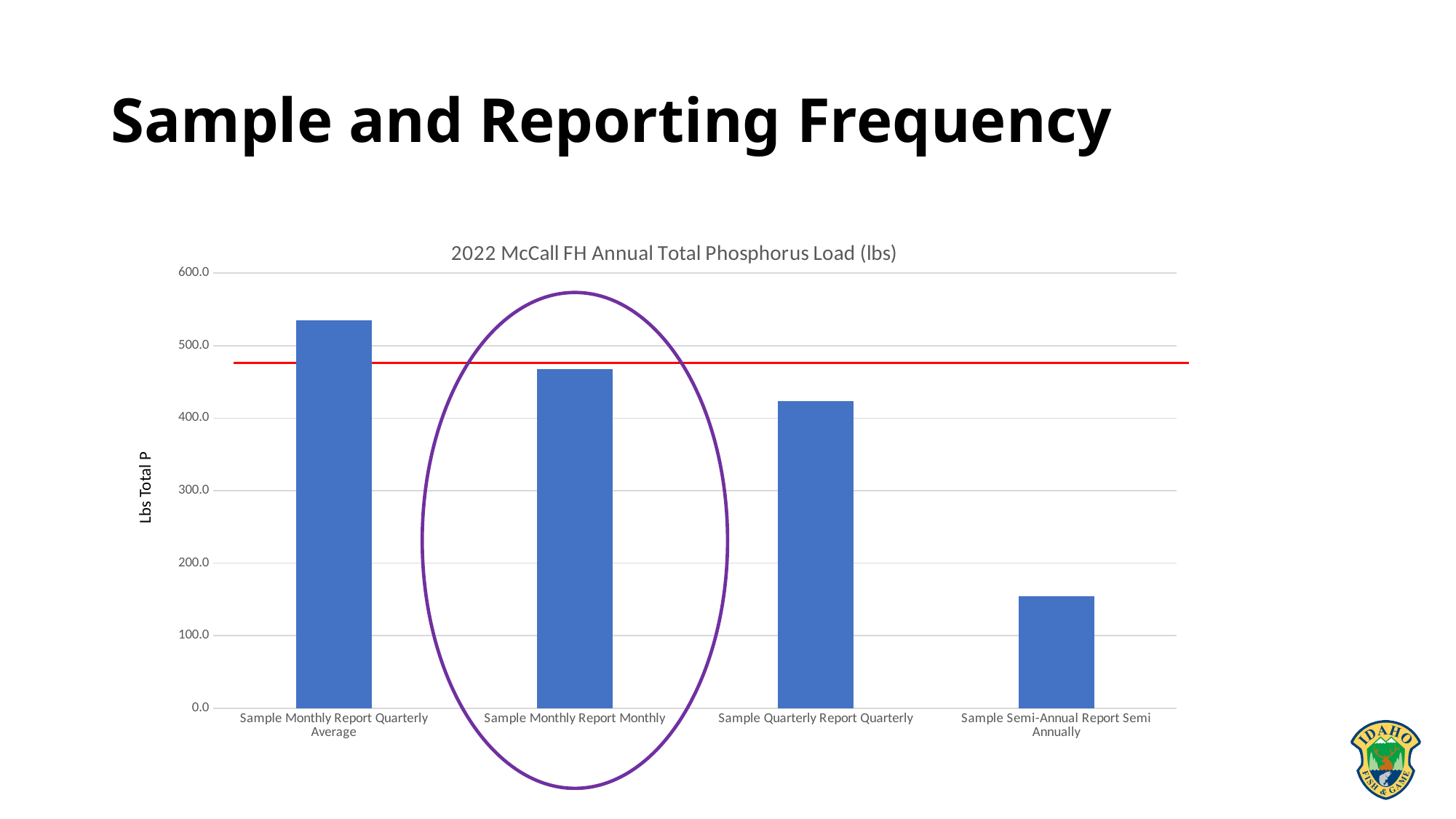
What kind of chart is shown on the slide? bar chart Which category has the highest annual total phosphorus load? Sample Monthly Report Quarterly Average Is the value for Sample Quarterly Report Quarterly greater or less than 400.0? greater How many categories are plotted on the x axis of the chart? 4 Do the bar values rise or fall from left to right across the x axis? fall What is the title of the chart? 2022 McCall FH Annual Total Phosphorus Load (lbs) Which is larger, the value for Sample Monthly Report Monthly or the value for Sample Quarterly Report Quarterly? Sample Monthly Report Monthly Which category has the lowest annual total phosphorus load? Sample Semi-Annual Report Semi Annually What is the label on the y axis of the chart? Lbs Total P Is the value for Sample Monthly Report Monthly greater or less than 500.0? less Is the value for Sample Monthly Report Quarterly Average greater or less than 500.0? greater